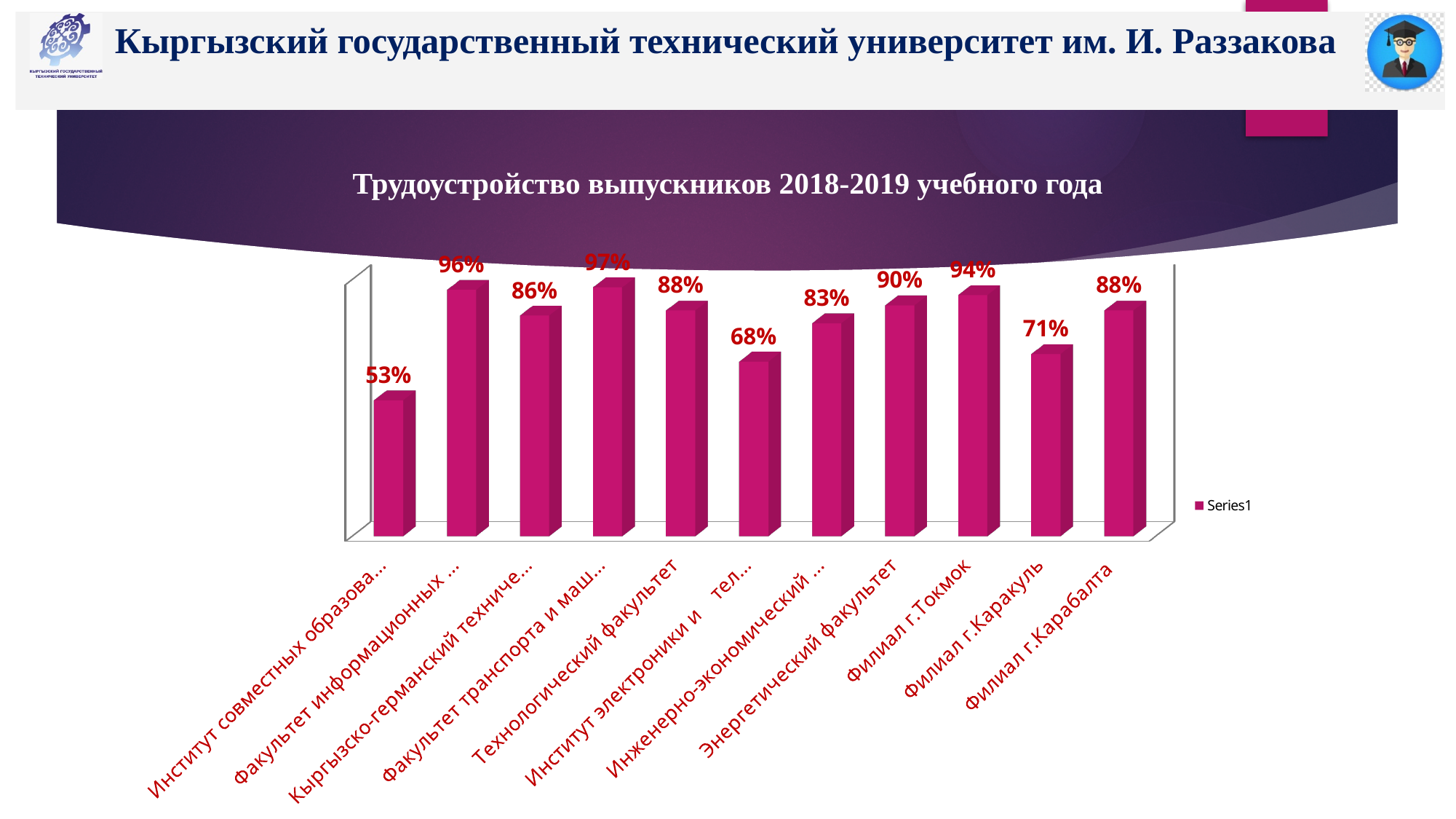
What is the value for Филиал г.Карабалта? 88% What is the value for Технологический факультет? 88% What is the value for Филиал г.Токмок? 94% What is the highest value shown in the chart? 97% What is the title of the chart? Трудоустройство выпускников 2018-2019 учебного года What is the value for Филиал г.Каракуль? 71% How many categories (bars) are shown in the chart? 11 What is the lowest value shown in the chart? 53% How many series does the legend list? 1 What is the value for Энергетический факультет? 90% What type of chart is shown on the slide? bar chart What is the difference between the values for Филиал г.Токмок and Филиал г.Каракуль? 23%